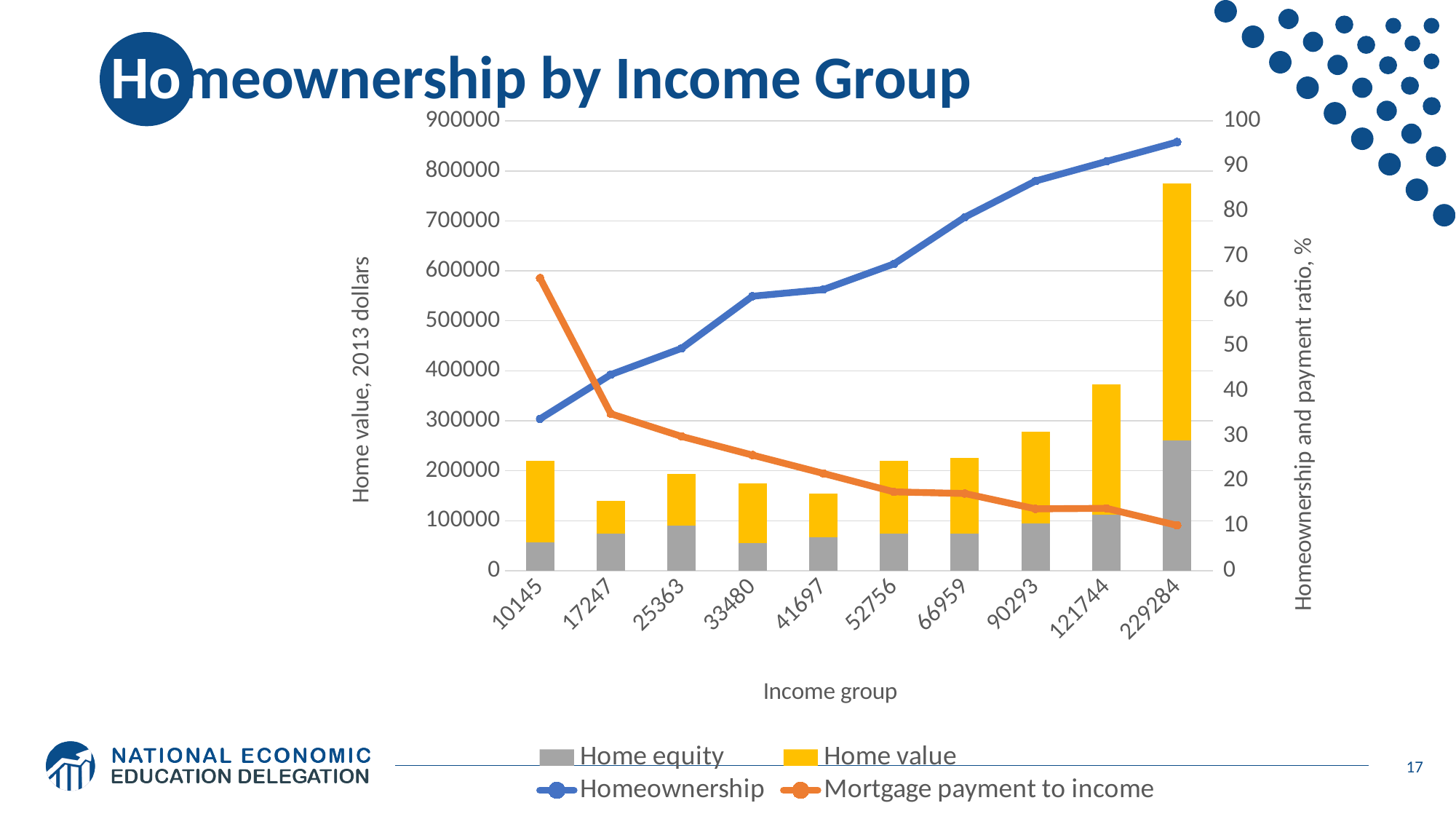
Is the Homeownership value for income group 10145 greater or less than 40? less Does the Homeownership line rise or fall as income group increases? Rises Does the Mortgage payment to income line rise or fall as income group increases? Falls How many income groups are shown on the x axis? 10 Which income group has the tallest Home value bar? 229284 Is the Mortgage payment to income value for income group 10145 greater or less than 60? greater What kind of chart is shown on the slide? A combination of a stacked bar chart and line chart Is the Homeownership value for income group 229284 greater or less than 90? greater How many series does the legend list? 4 Which income group has the shortest Home value bar? 17247 Which income group has a taller Home value bar, 90293 or 121744? 121744